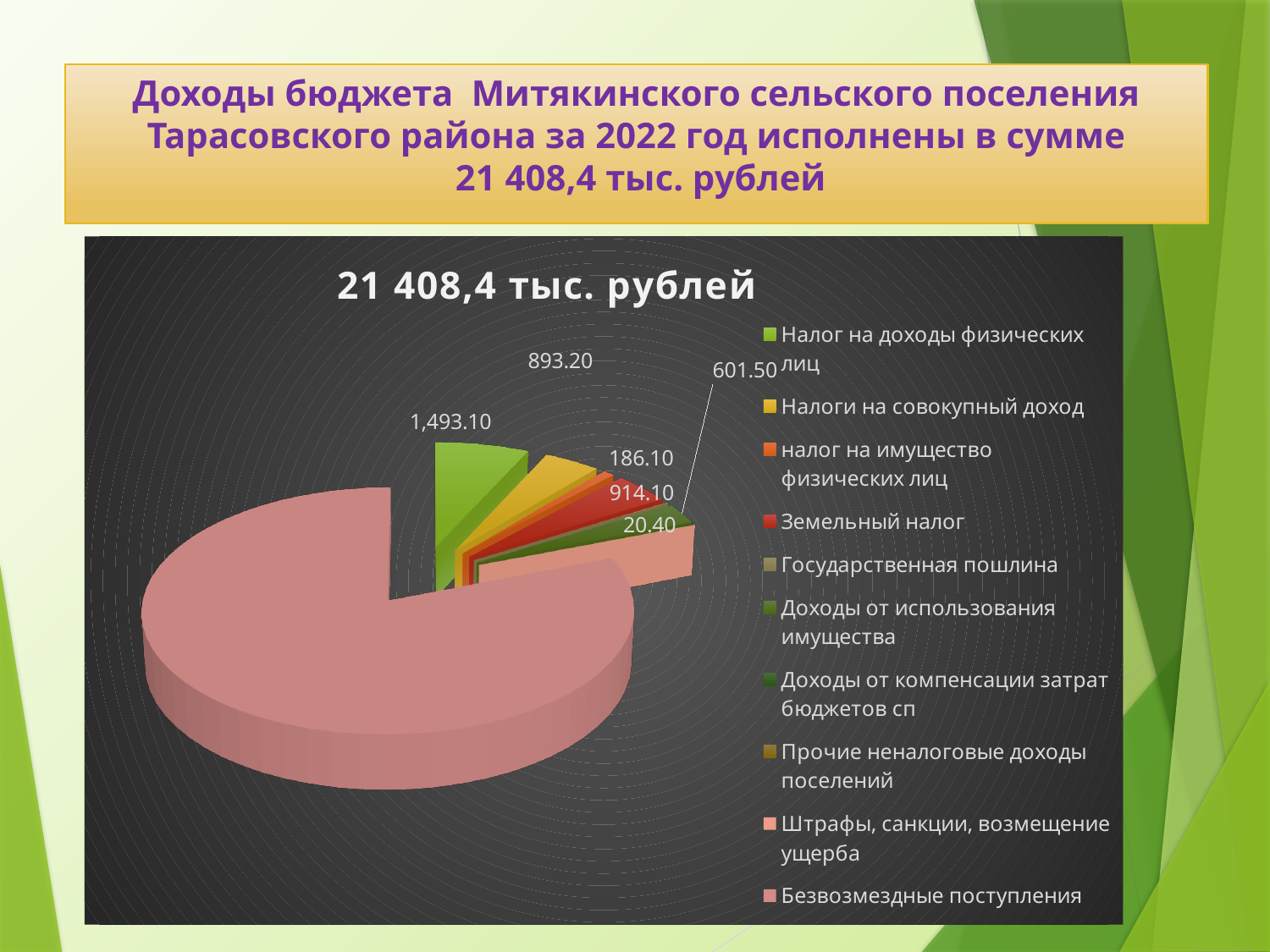
What colour is the slice for Безвозмездные поступления? pink What is the value for Земельный налог? 914.10 What is the value for Налоги на совокупный доход? 893.20 What is the value for Налог на доходы физических лиц? 1,493.10 What kind of chart is shown on the slide? pie chart What is the title of the chart? 21 408,4 тыс. рублей What is the difference between Земельный налог (914.10) and налог на имущество физических лиц (186.10)? 728.00 Which category has the largest slice of the pie? Безвозмездные поступления Which is larger, Налог на доходы физических лиц or Налоги на совокупный доход? Налог на доходы физических лиц What is the value for налог на имущество физических лиц? 186.10 What is the difference between Налог на доходы физических лиц (1,493.10) and Налоги на совокупный доход (893.20)? 599.90 How many entries does the chart legend list? 10